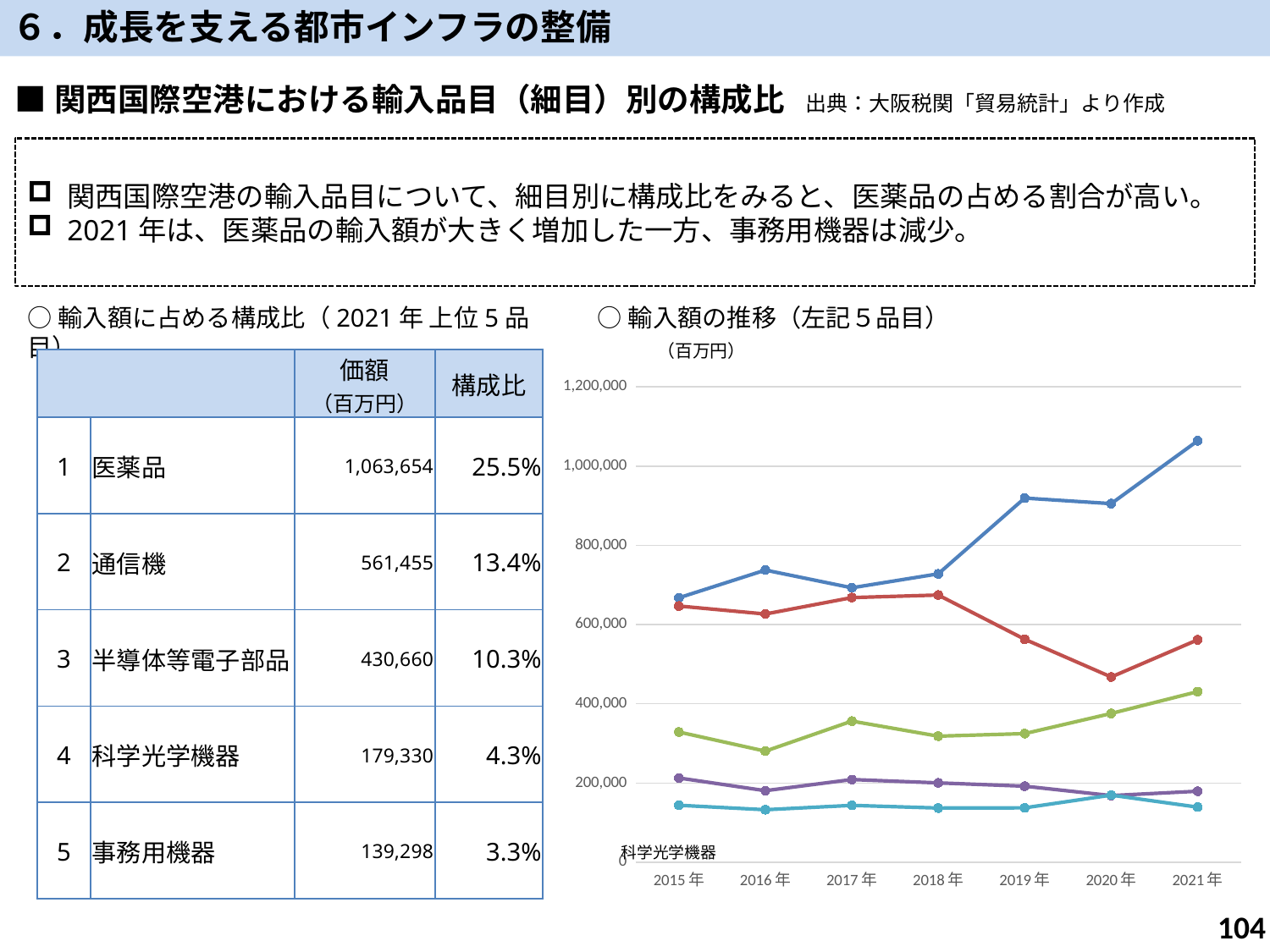
In the 輸入額の推移 chart, in which year does the red line reach its lowest value? 2020年 What kind of chart is the 輸入額の推移（左記5品目） chart? line chart In the 輸入額の推移 chart, is the value of the red line in 2020年 greater or less than 600,000? less What unit is shown above the y axis of the 輸入額の推移 chart? 百万円 In the 輸入額の推移 chart, is the value of the green line in 2016年 greater or less than 200,000? greater How many years are plotted along the x axis of the 輸入額の推移 chart? 7 In the 輸入額の推移 chart, which is larger in 2019年, the green line or the purple line? the green line How many lines are plotted in the 輸入額の推移 chart? 5 In the 輸入額の推移 chart, which line has the highest value in 2021年? the blue line In the 輸入額の推移 chart, in which year does the blue line reach its highest value? 2021年 In the 輸入額の推移 chart, is the value of the light blue line in 2016年 greater or less than 200,000? less